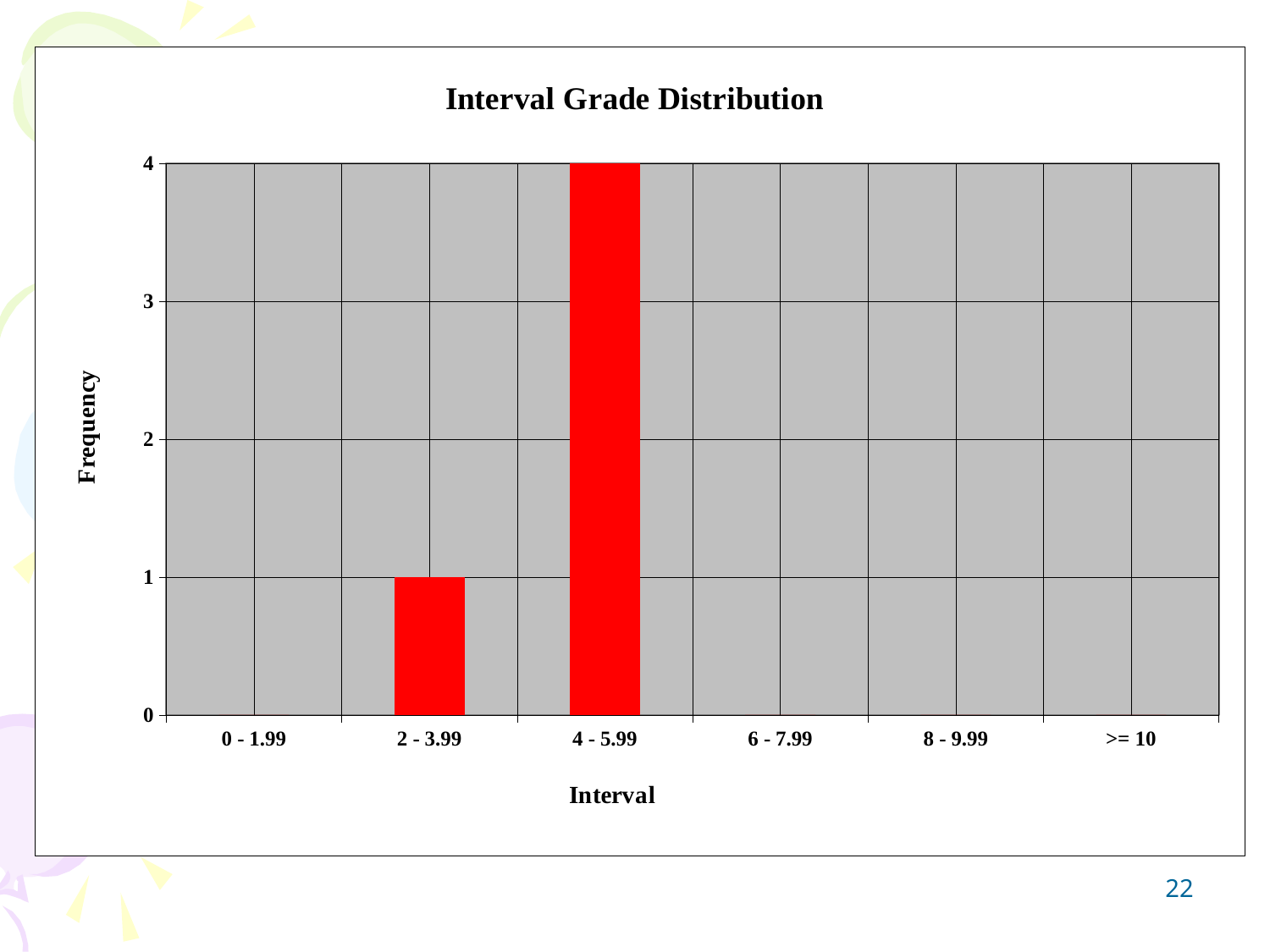
What is the difference in frequency between the 4 - 5.99 and 2 - 3.99 intervals? 3 What is the frequency for the >= 10 interval? 0 Which has a higher frequency, the 2 - 3.99 interval or the 4 - 5.99 interval? 4 - 5.99 What is the frequency for the 2 - 3.99 interval? 1 What is the frequency for the 6 - 7.99 interval? 0 Is the frequency for the 4 - 5.99 interval greater or less than 3? greater What is the label of the y axis? Frequency What type of chart is shown on the slide? bar chart What is the title of the chart? Interval Grade Distribution How many interval categories are shown on the x axis? 6 Which interval has the highest frequency? 4 - 5.99 What is the frequency for the 4 - 5.99 interval? 4